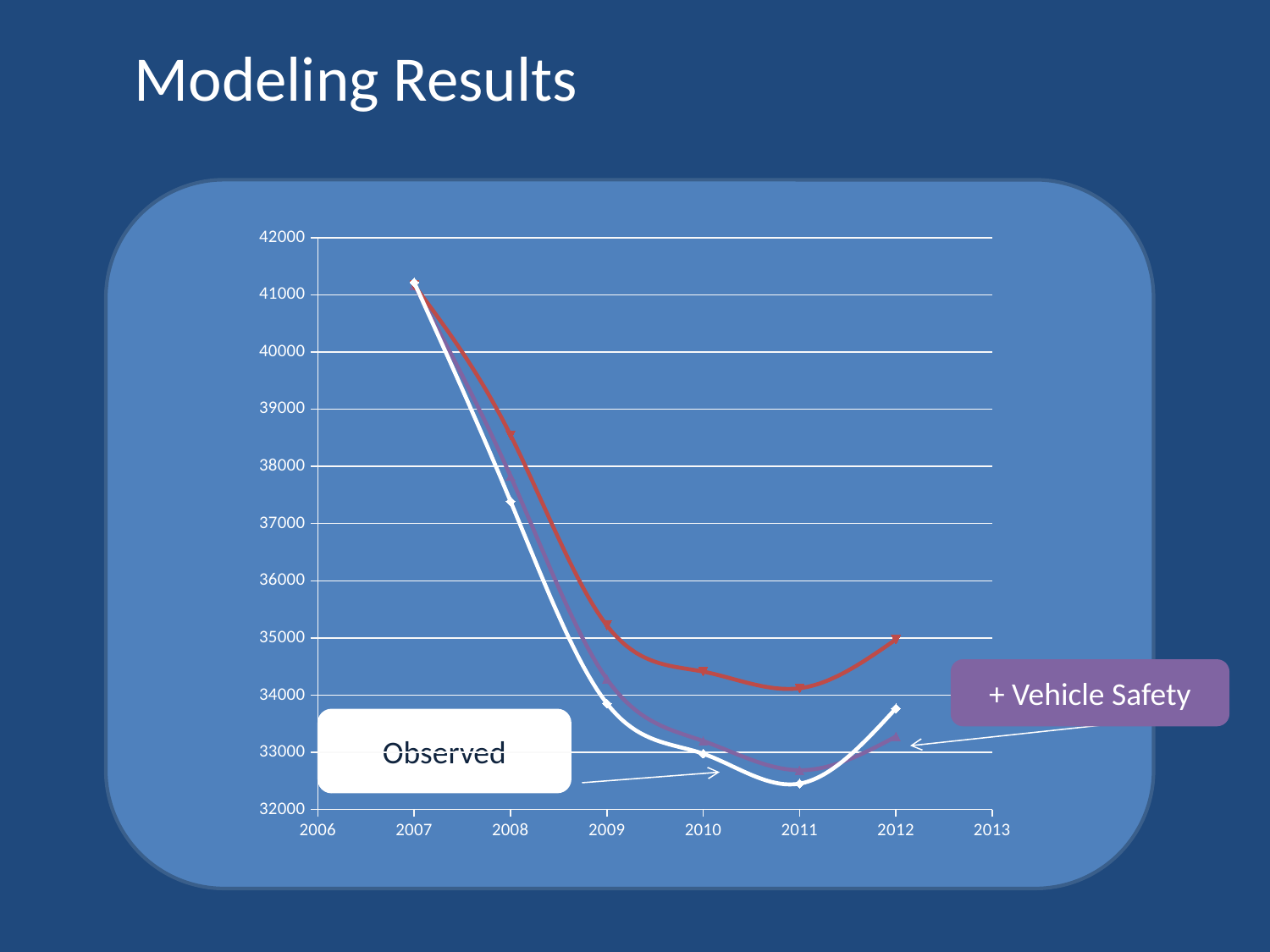
What label is attached to the white line on the chart? Observed How many data points does the Observed line have? 6 How many lines are plotted on the chart? 3 Is the Observed value for 2011 greater or less than 33000? less Is the + Vehicle Safety value for 2009 greater or less than 35000? less In 2010, which is higher: the red line or the Observed line? the red line Does the Observed line rise or fall from 2007 to 2011? fall In which year is the Observed line at its lowest? 2011 Is the Observed value for 2008 greater or less than 37000? greater What kind of chart is shown on the slide? line chart In which year is the Observed line at its highest? 2007